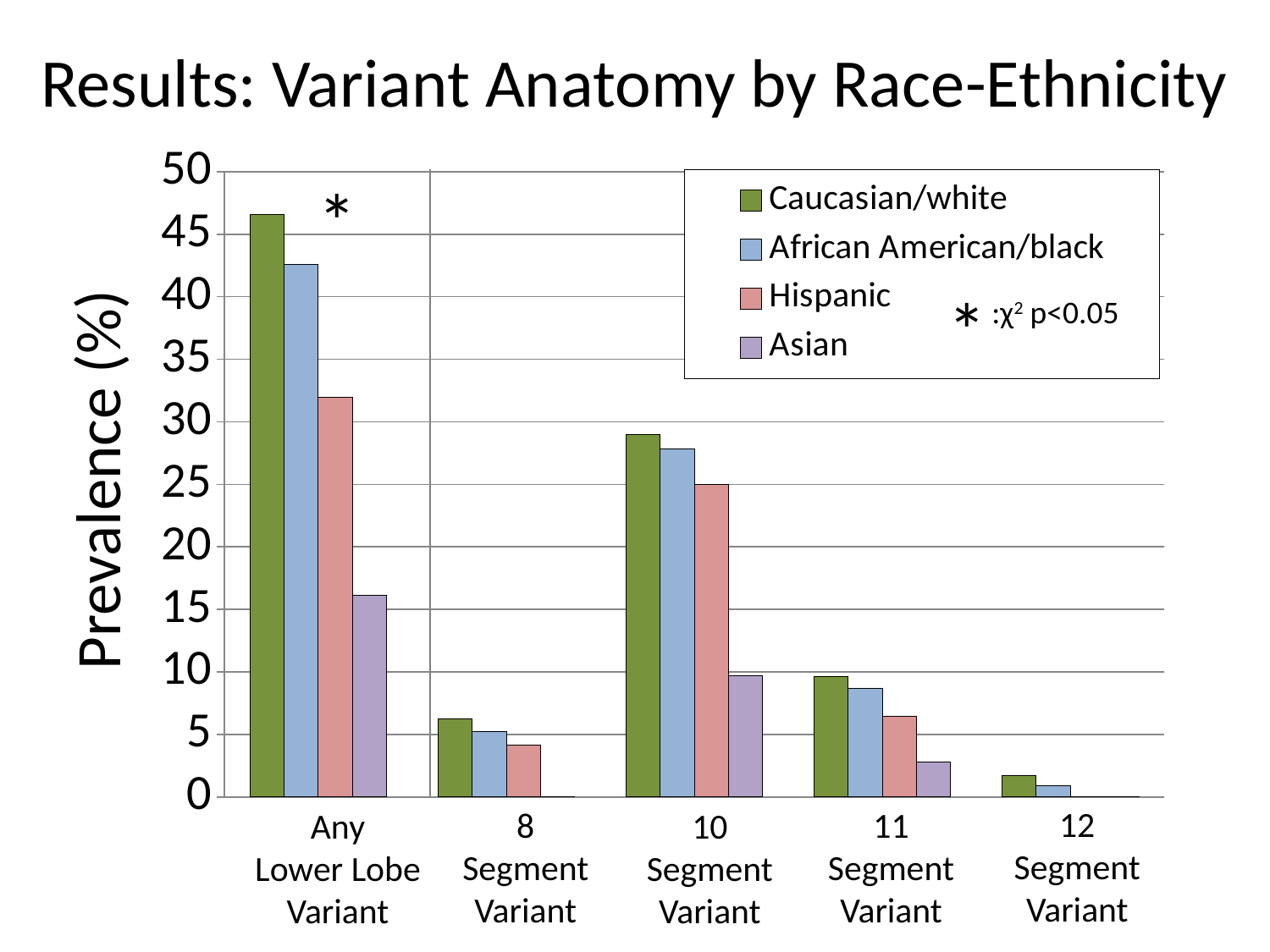
Is the Caucasian/white prevalence for Any Lower Lobe Variant greater or less than 45? greater For which variant category is the Caucasian/white prevalence highest? Any Lower Lobe Variant How many series does the legend list? 4 Which race-ethnicity group has the lowest prevalence for Any Lower Lobe Variant? Asian Is the Hispanic prevalence for Any Lower Lobe Variant greater or less than 30? greater Is the Asian prevalence for 10 Segment Variant greater or less than 15? less Which race-ethnicity group has the highest prevalence for Any Lower Lobe Variant? Caucasian/white What does the asterisk on the chart indicate? χ² p<0.05 What kind of chart is shown on the slide? Bar chart What is the label of the y axis? Prevalence (%) For the 10 Segment Variant, which is larger: the Caucasian/white prevalence or the Hispanic prevalence? Caucasian/white How many variant categories are shown along the x axis? 5